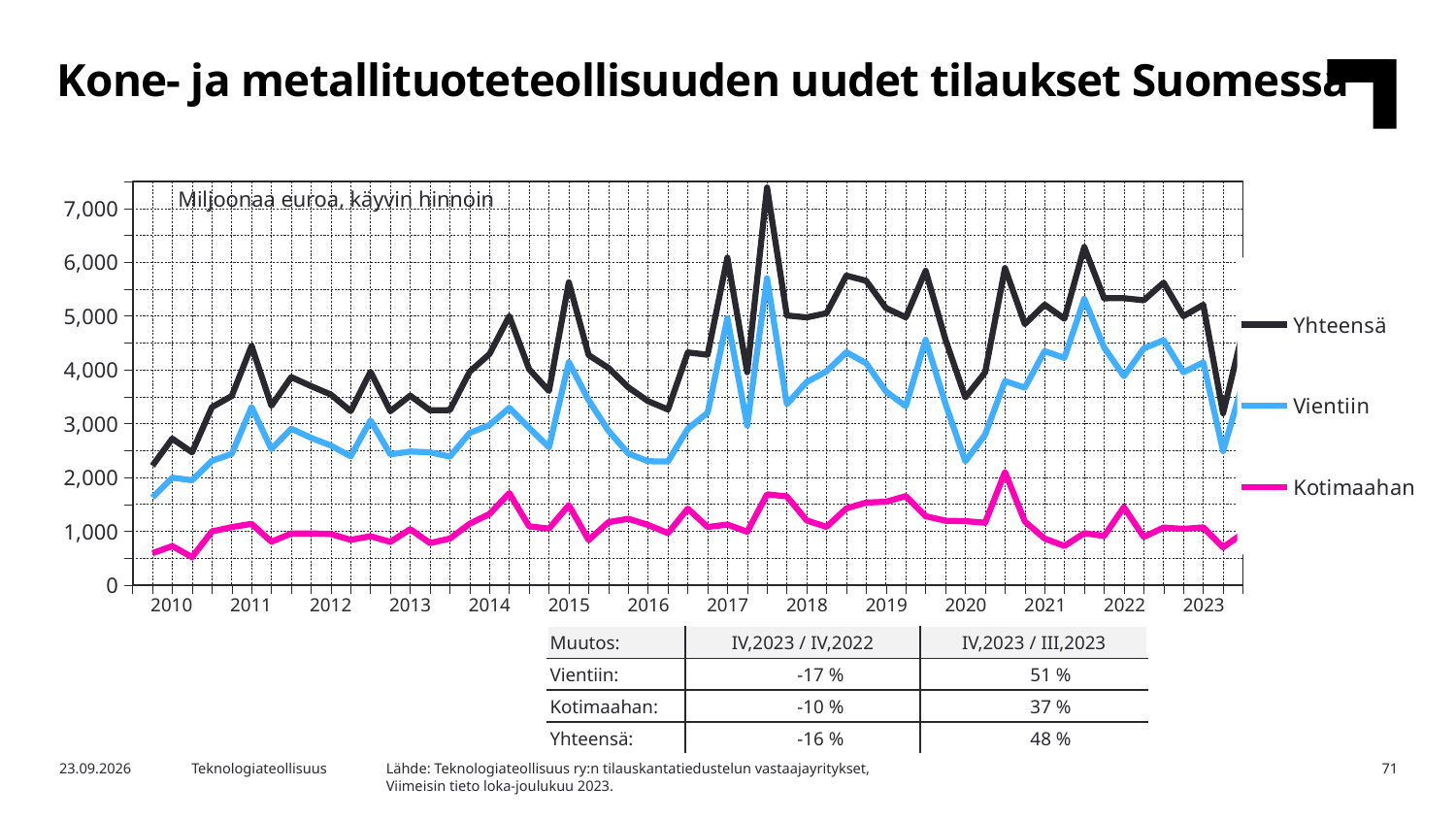
Which series are listed in the chart legend? Yhteensä, Vientiin, Kotimaahan How many years are labelled on the x axis of the chart? 14 What type of chart is shown on the slide? line chart Which series has the highest values throughout the chart? Yhteensä Is the lowest value of the Vientiin series in 2023 greater or less than 3,000? less Which series is larger in 2021, Vientiin or Kotimaahan? Vientiin How many series does the chart legend list? 3 Which series has the lowest values throughout the chart? Kotimaahan What unit is stated in the label inside the chart area? Miljoonaa euroa, käyvin hinnoin Is the peak value of the Yhteensä series in 2017 greater or less than 7,000? greater Does the Yhteensä series overall rise or fall from 2010 to 2017? rise Is the first value of the Vientiin series in 2010 greater or less than 2,000? less